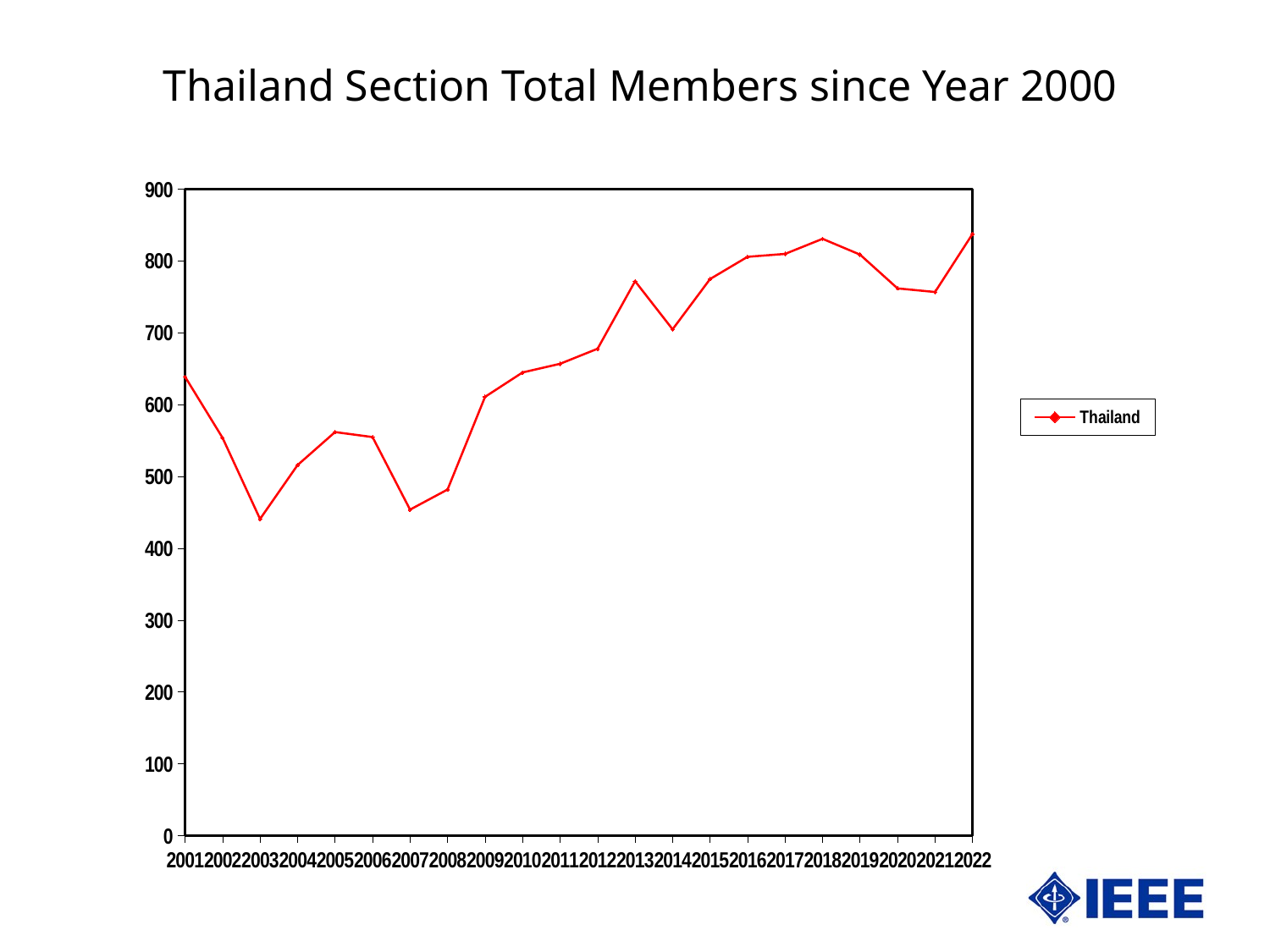
Is the value for 2018 greater or less than 800? greater Which year has the larger value, 2001 or 2003? 2001 Is the value for 2013 greater or less than 700? greater How many series does the legend list? 1 How many years are plotted along the x axis? 22 Do the values generally rise or fall from 2001 to 2022? rise Is the value for 2001 greater or less than 600? greater What kind of chart is shown on the slide? line chart Which year has the larger value, 2013 or 2014? 2013 What is the title of the chart? Thailand Section Total Members since Year 2000